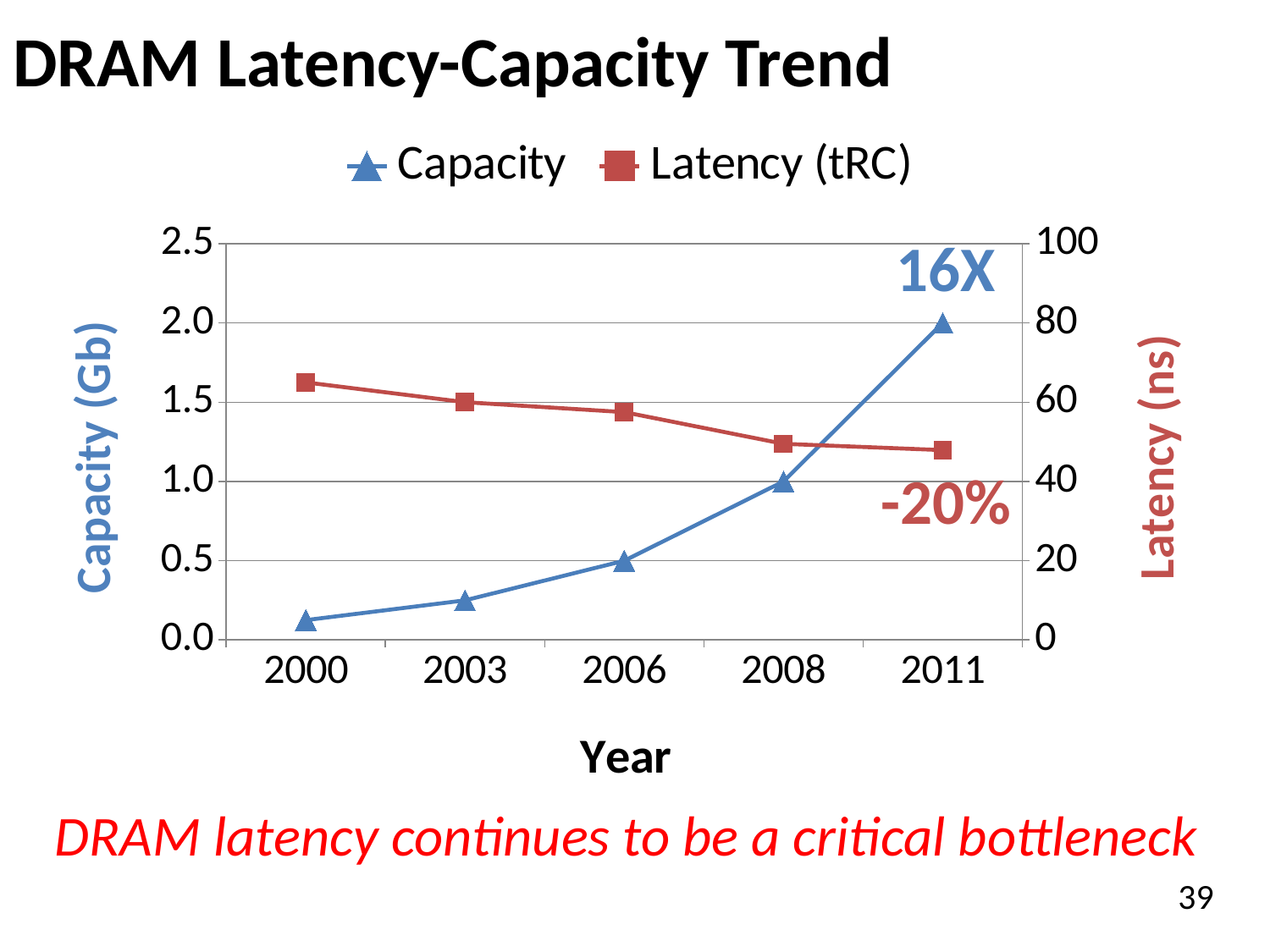
Does the Latency (tRC) series rise or fall from 2000 to 2011? fall Is the Capacity value for 2006 greater or less than 1.0 Gb? less How many years are plotted along the x axis? 5 What kind of chart is shown on the slide? line chart Is the Latency (tRC) value for 2011 greater or less than 60 ns? less Is the Latency (tRC) value for 2000 greater or less than 60 ns? greater In which year is Latency (tRC) highest? 2000 What annotation is printed next to the Capacity series at 2011? 16X How many series does the legend list? 2 Does the Capacity series rise or fall from 2000 to 2011? rise In which year is Capacity lowest? 2000 In which year is Capacity highest? 2011